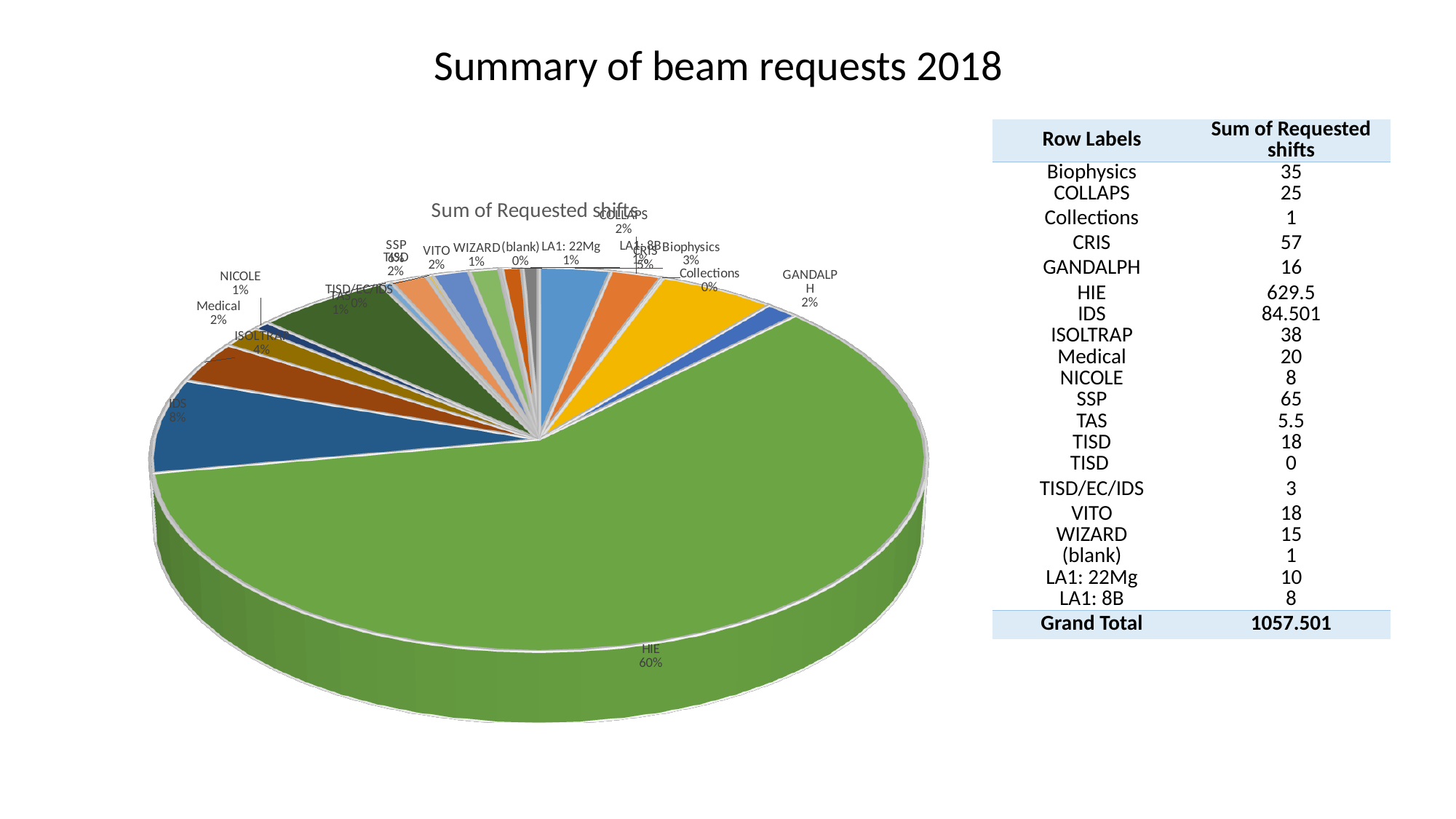
What share of the pie does Biophysics account for? 3% Which slice is larger in the pie chart, HIE or IDS? HIE What share of the pie does GANDALPH account for? 2% What share of the pie does Collections account for? 0% What is the title of the pie chart? Sum of Requested shifts Which slice is larger in the pie chart, IDS or ISOLTRAP? IDS Which category has the largest slice of the pie chart? HIE What kind of chart is shown on the slide? pie chart